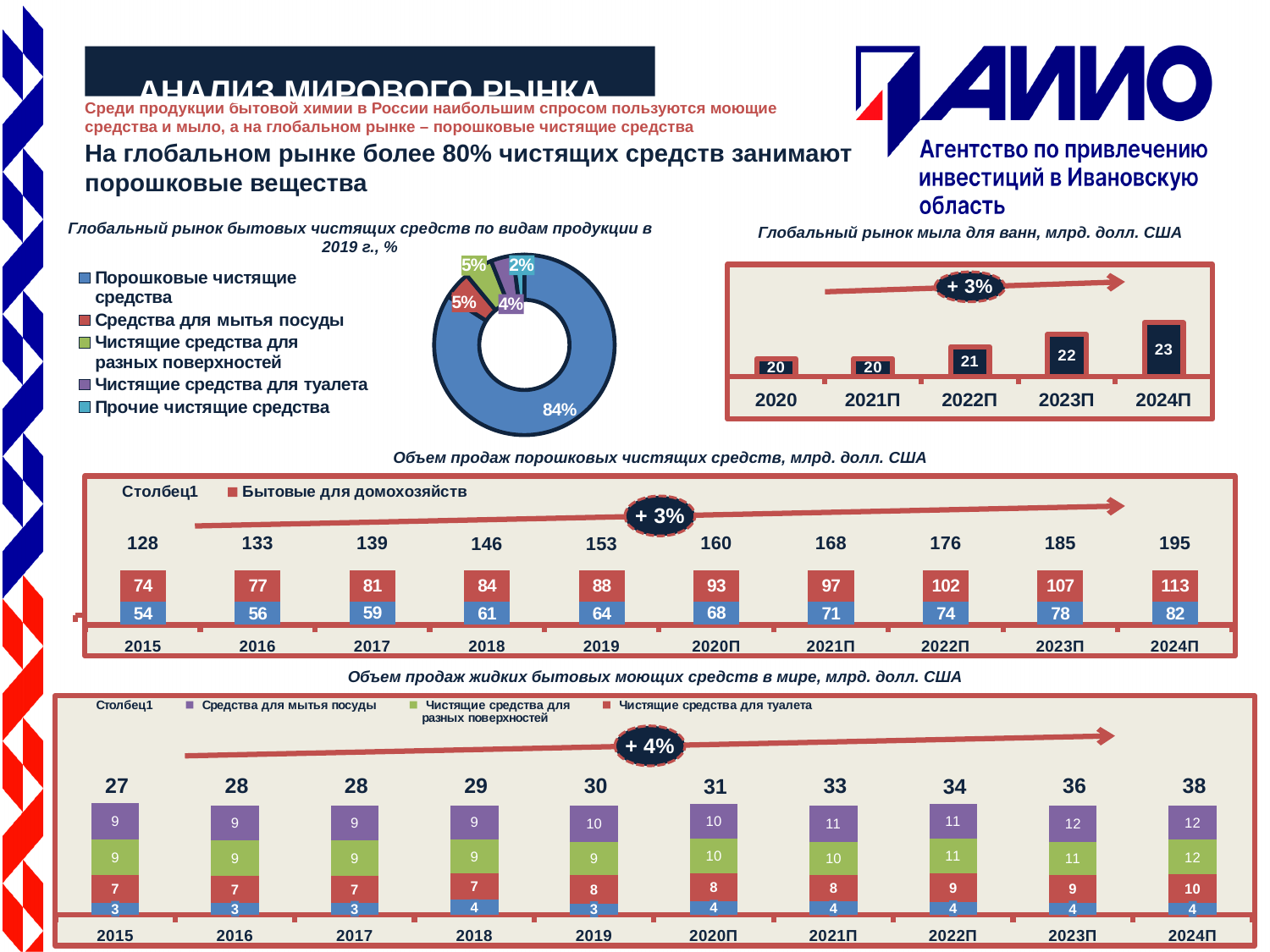
In the chart 'Объем продаж порошковых чистящих средств, млрд. долл. США', what is the total of the stacked bar for 2024П? 195 In the chart 'Глобальный рынок бытовых чистящих средств по видам продукции в 2019 г., %', what share do Порошковые чистящие средства have? 84% In the chart 'Объем продаж порошковых чистящих средств, млрд. долл. США', what is the value of 'Бытовые для домохозяйств' for 2019? 88 In the chart 'Объем продаж жидких бытовых моющих средств в мире, млрд. долл. США', which is larger: the total for 2015 or the total for 2019? 2019 In the chart 'Объем продаж порошковых чистящих средств, млрд. долл. США', what is the difference between the 'Бытовые для домохозяйств' values for 2024П and 2015? 39 How many entries does the legend of the chart 'Глобальный рынок бытовых чистящих средств по видам продукции в 2019 г., %' list? 5 In the chart 'Объем продаж жидких бытовых моющих средств в мире, млрд. долл. США', what is the value of 'Чистящие средства для туалета' for 2024П? 10 What kind of chart is 'Глобальный рынок бытовых чистящих средств по видам продукции в 2019 г., %'? Doughnut chart In the chart 'Глобальный рынок мыла для ванн, млрд. долл. США', how many years are shown on the x axis? 5 In the chart 'Глобальный рынок мыла для ванн, млрд. долл. США', do the values rise or fall from 2020 to 2024П? Rise In the chart 'Объем продаж жидких бытовых моющих средств в мире, млрд. долл. США', which year has the highest total? 2024П In the chart 'Глобальный рынок мыла для ванн, млрд. долл. США', what is the value for 2024П? 23